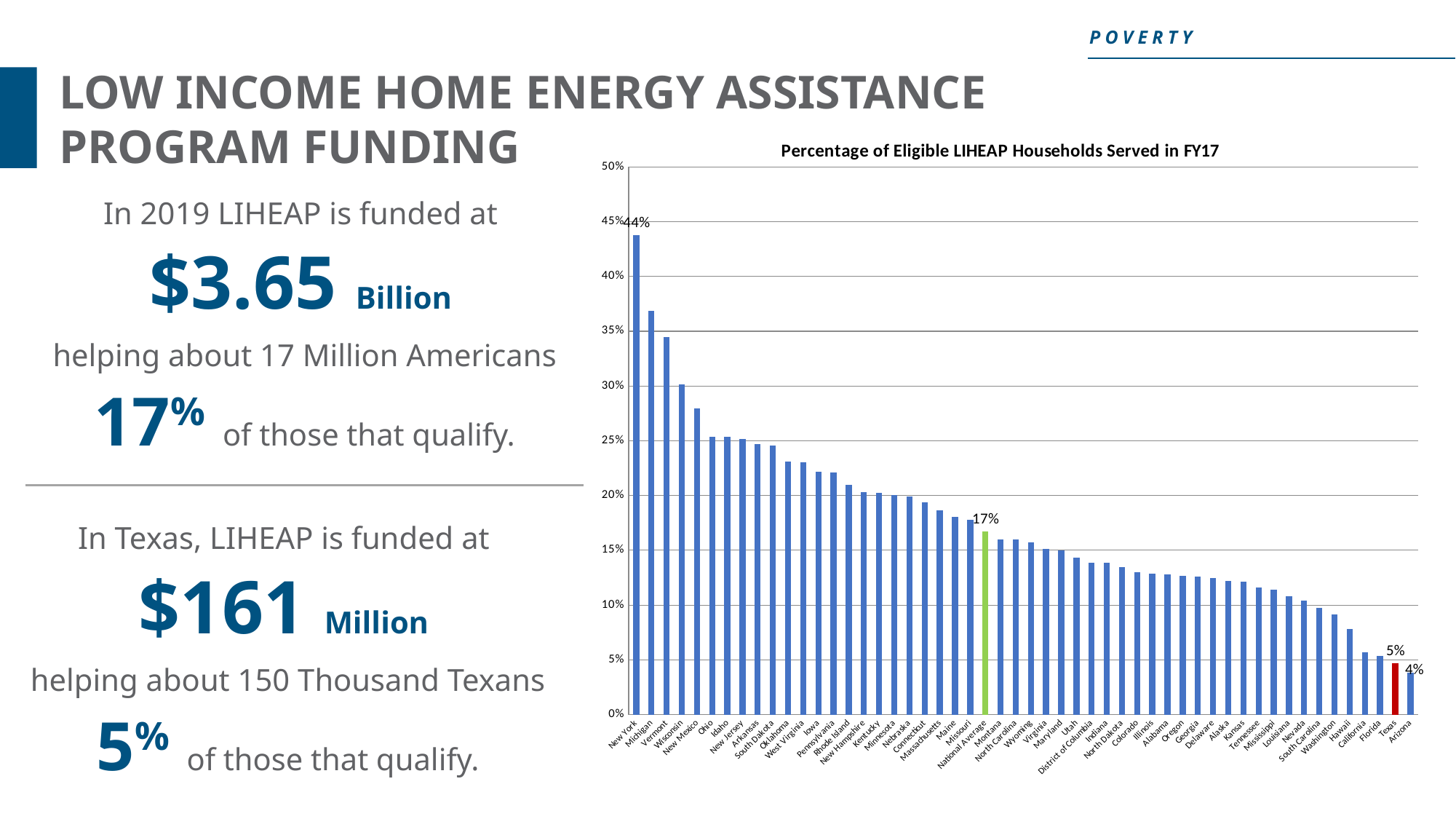
Do the values rise or fall moving from left to right along the x axis? fall Which category has the lowest value in the chart? Arizona What percentage of eligible LIHEAP households were served in New York? 44% What is the title of the chart? Percentage of Eligible LIHEAP Households Served in FY17 How many percentage points higher is New York than the National Average? 27% Is the value for Hawaii greater or less than 10%? less What is the difference between the National Average and Texas? 12% Is the value for Michigan greater or less than 35%? greater What kind of chart is shown on the slide? bar chart Which category has the highest value in the chart? New York What percentage of eligible LIHEAP households were served in Texas? 5% What is the value shown for the National Average? 17%